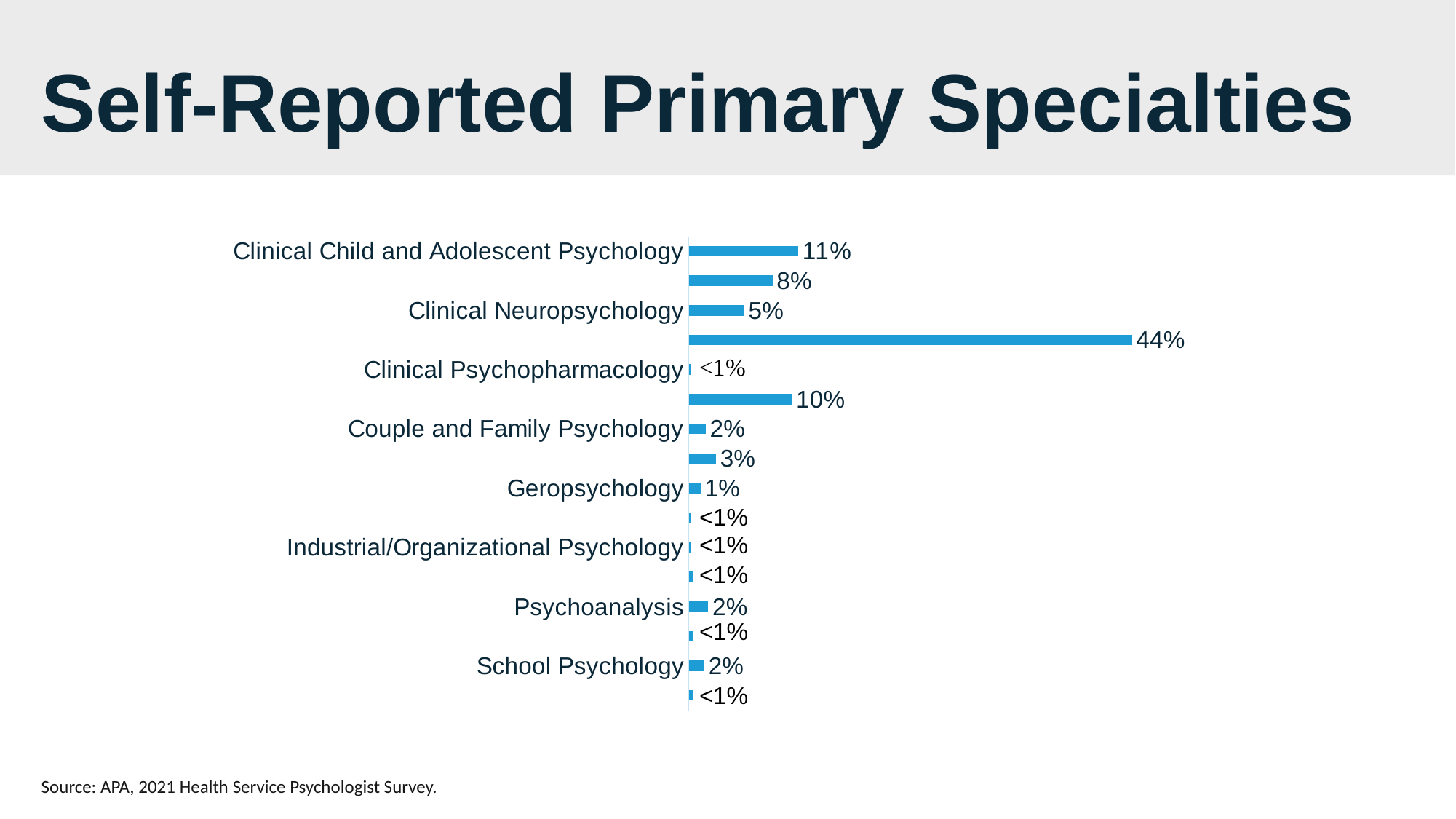
What is the value for Clinical Child and Adolescent Psychology? 11% What is the difference between the values for Clinical Child and Adolescent Psychology and Clinical Neuropsychology? 6% What is the value for Geropsychology? 1% What is the value for Clinical Neuropsychology? 5% What kind of chart is shown on the slide? bar chart What is the title of the slide? Self-Reported Primary Specialties What is the value for Clinical Psychopharmacology? <1% What is the value for School Psychology? 2% What is the largest value shown on the chart? 44% What is the value for Couple and Family Psychology? 2% Which has the larger value, Couple and Family Psychology or Geropsychology? Couple and Family Psychology How many bars are plotted on the chart? 16